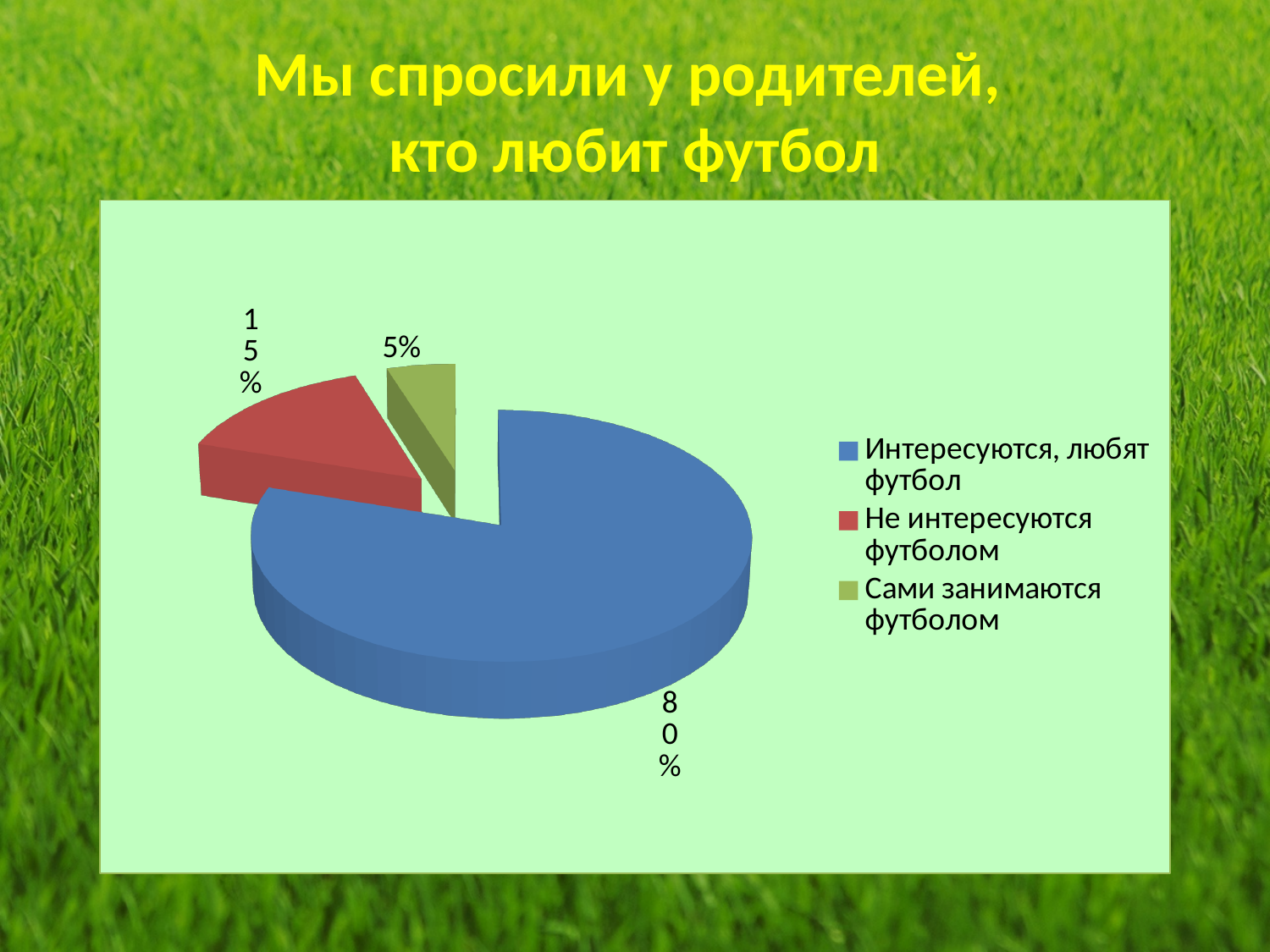
Which category has the smallest share of the pie? Сами занимаются футболом How many slices does the pie chart have? 3 What kind of chart is shown on the slide? pie chart What percentage of parents are in the category "Интересуются, любят футбол"? 80% Which is larger: the share for "Не интересуются футболом" or the share for "Сами занимаются футболом"? Не интересуются футболом What is the difference in percentage points between "Интересуются, любят футбол" and "Не интересуются футболом"? 65 How many entries does the legend list? 3 What percentage of parents are in the category "Не интересуются футболом"? 15% What percentage of parents are in the category "Сами занимаются футболом"? 5% What colour is the slice for "Не интересуются футболом"? red What is the difference in percentage points between "Не интересуются футболом" and "Сами занимаются футболом"? 10 Which category has the largest share of the pie? Интересуются, любят футбол